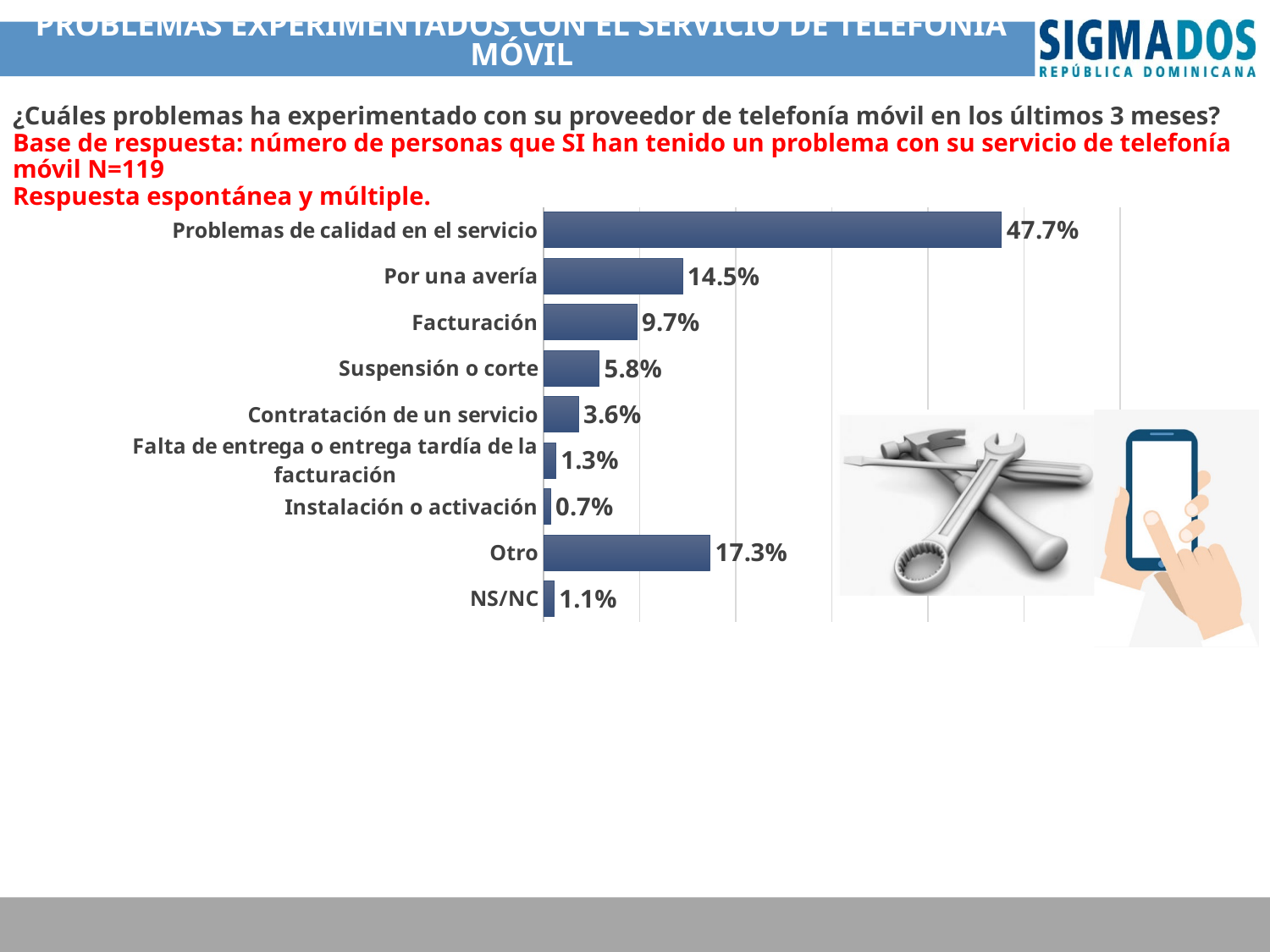
How many categories are shown in the chart? 9 What is the value for NS/NC? 1.1% Which category has the lowest value? Instalación o activación What is the difference between Problemas de calidad en el servicio and Por una avería? 33.2% What kind of chart is shown on the slide? Bar chart What is the difference between Suspensión o corte and Contratación de un servicio? 2.2% What is the value for Problemas de calidad en el servicio? 47.7% What is the value for Facturación? 9.7% What is the value for Otro? 17.3% What is the value for Por una avería? 14.5% Which is larger, Otro or Por una avería? Otro Which category has the highest value? Problemas de calidad en el servicio